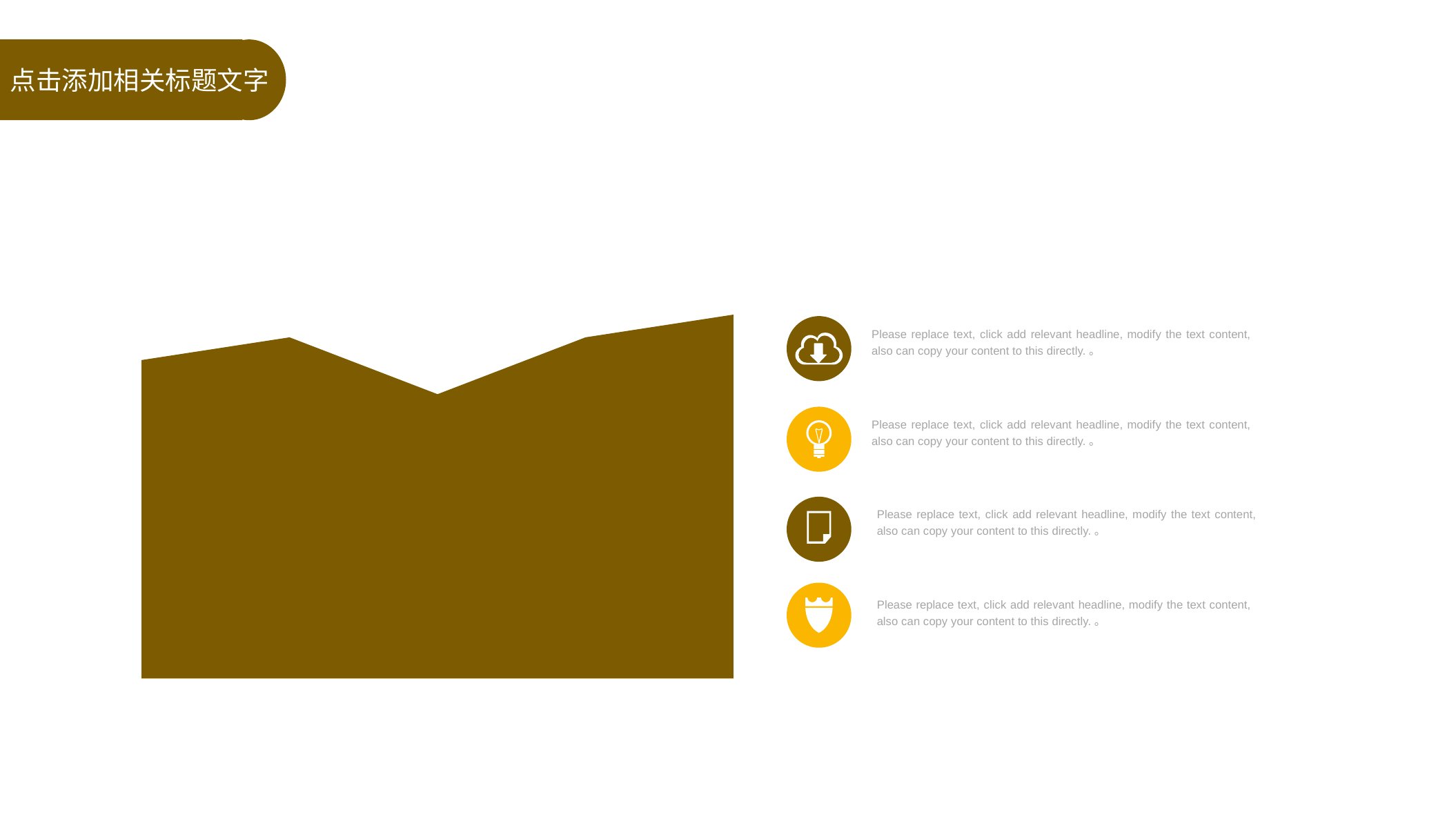
How many data points does the area chart on the left plot? 5 Does the area chart on the left show any axis labels or data labels? no What kind of chart is shown on the left of the slide? area chart In the area chart on the left, is the value at the right end higher or lower than the value at the left end? higher In the area chart on the left, is the lowest point at the left end, in the middle, or at the right end? in the middle In the area chart on the left, is the highest point at the left end, in the middle, or at the right end? at the right end What colour is the filled area in the chart on the left? brown